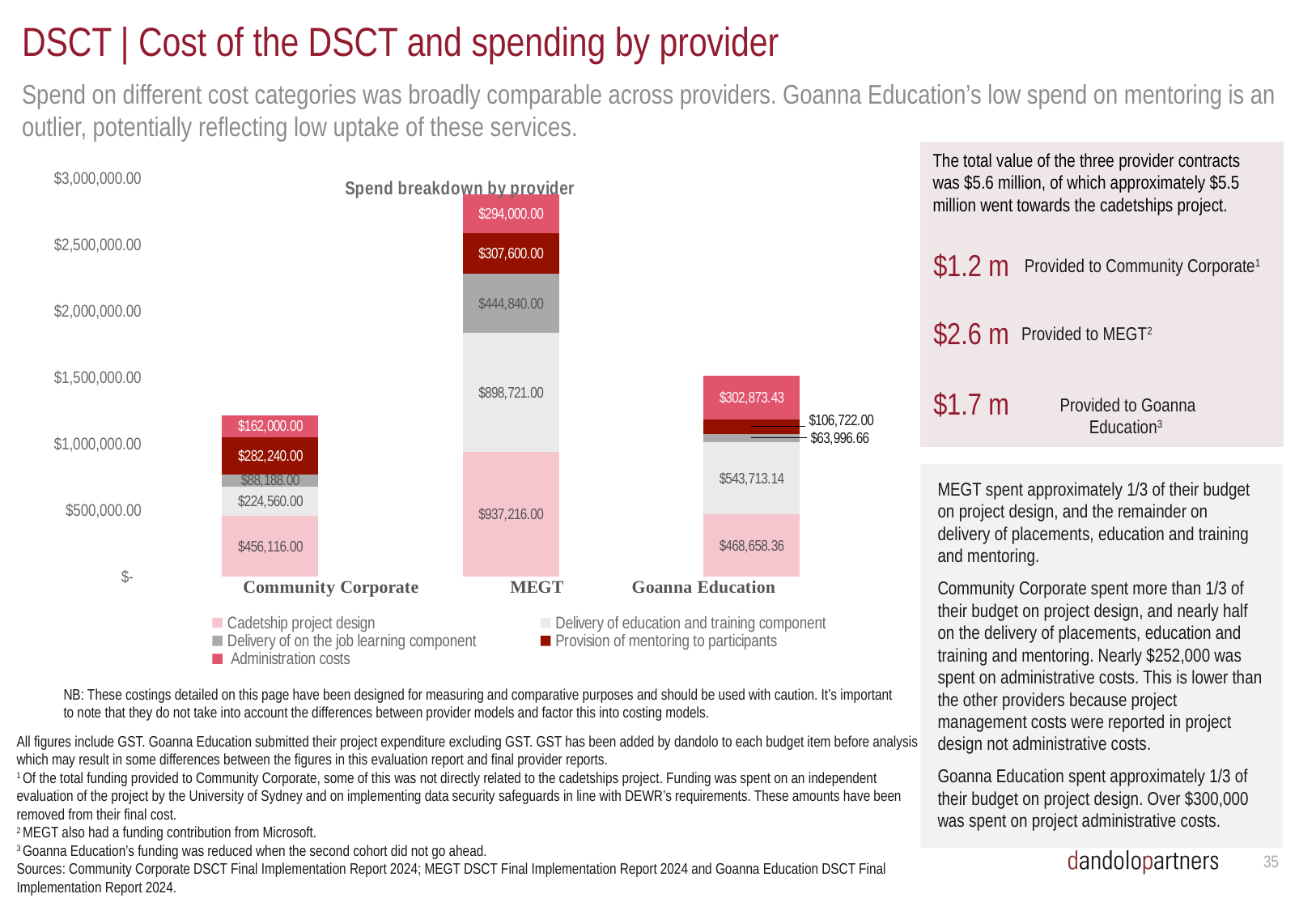
Which provider has the lowest value for Provision of mentoring to participants? Goanna Education What kind of chart is shown on the slide? Stacked bar chart What is the value for Administration costs for Goanna Education? $302,873.43 How many providers are shown on the x axis? 3 Is the total of the MEGT bar greater or less than $2,500,000.00? greater What is the total of the Community Corporate bar? $1,213,104.00 What is the value for Provision of mentoring to participants for Community Corporate? $282,240.00 What is the difference between the Administration costs for MEGT and for Community Corporate? $132,000.00 What is the value for Cadetship project design for MEGT? $937,216.00 Which is larger: the Delivery of education and training component for Goanna Education or for Community Corporate? Goanna Education How many series does the legend list? 5 Which provider has the highest value for Cadetship project design? MEGT